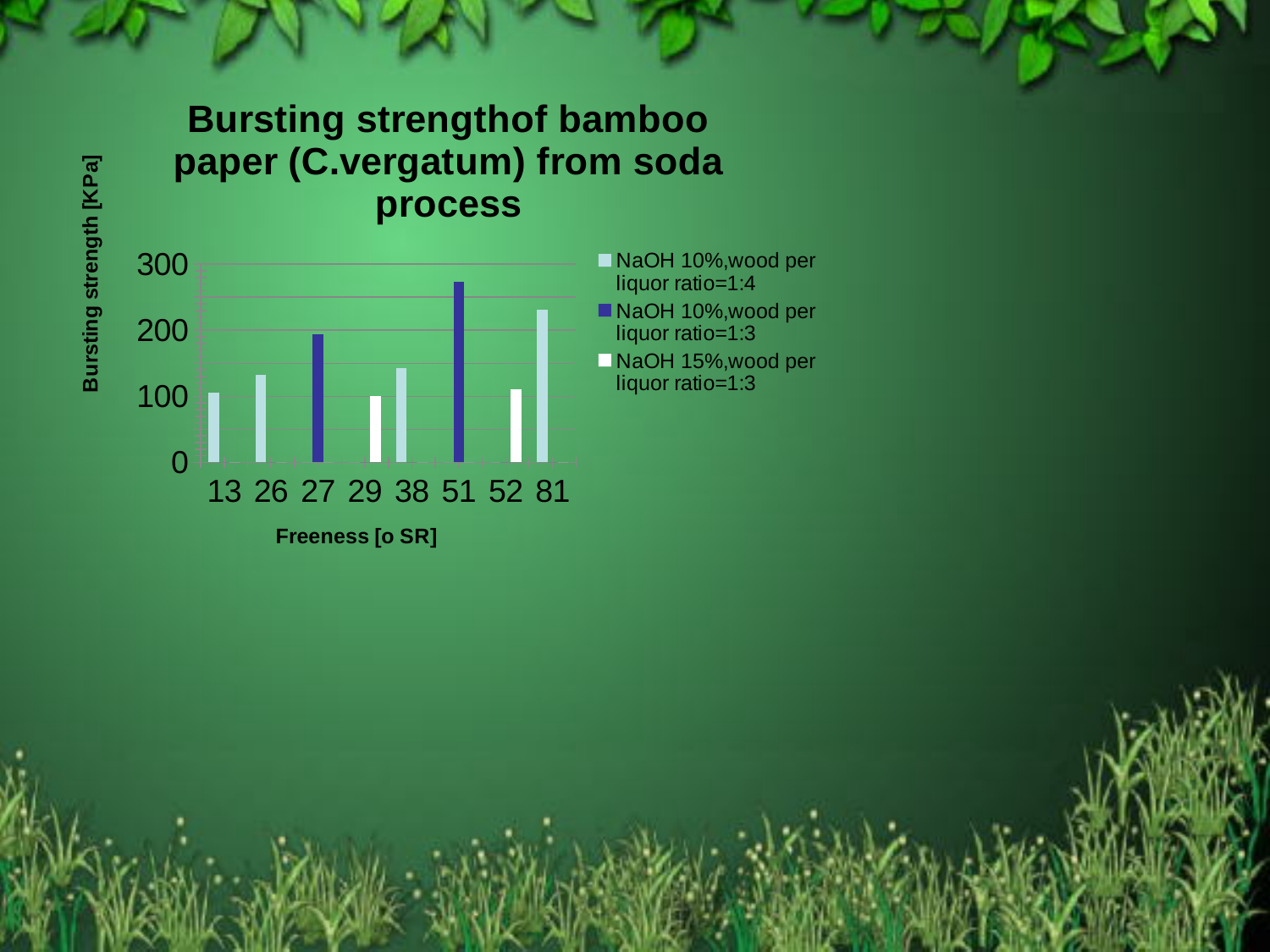
What kind of chart is shown on the slide? bar chart Is the bursting strength at freeness 81 greater or less than 200? greater How many series does the legend list? 3 Which has the higher bursting strength, freeness 51 or freeness 81? 51 How many freeness categories are shown on the x axis? 8 Which freeness value has the highest bursting strength? 51 Which has the higher bursting strength, freeness 27 or freeness 26? 27 Is the bursting strength at freeness 13 greater or less than 200? less What is the title of the y axis? Bursting strength [KPa] Is the bursting strength at freeness 51 greater or less than 200? greater